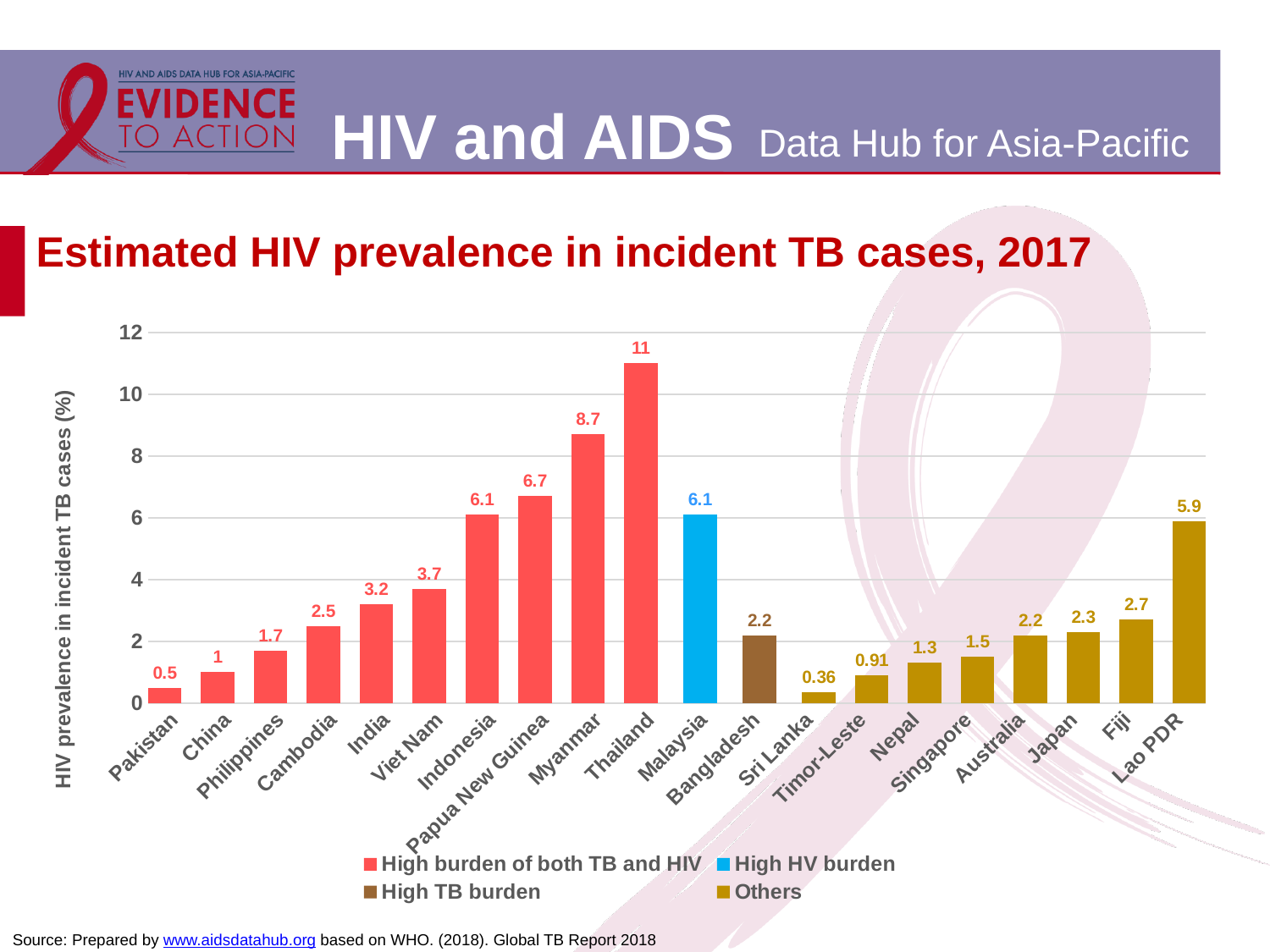
What is the estimated HIV prevalence in incident TB cases for Thailand? 11 How many countries are shown on the chart? 20 How many entries does the legend list? 4 What is the difference between the values for Myanmar and Papua New Guinea? 2 Which country has the lowest HIV prevalence in incident TB cases? Sri Lanka Which legend category does the Malaysia bar belong to? High HV burden What is the value shown for Lao PDR? 5.9 What kind of chart is shown on the slide? Bar chart What is the value shown for Sri Lanka? 0.36 Which country has the highest HIV prevalence in incident TB cases? Thailand Which has a higher value, India or Viet Nam? Viet Nam Is the value for Malaysia greater or less than 4? greater